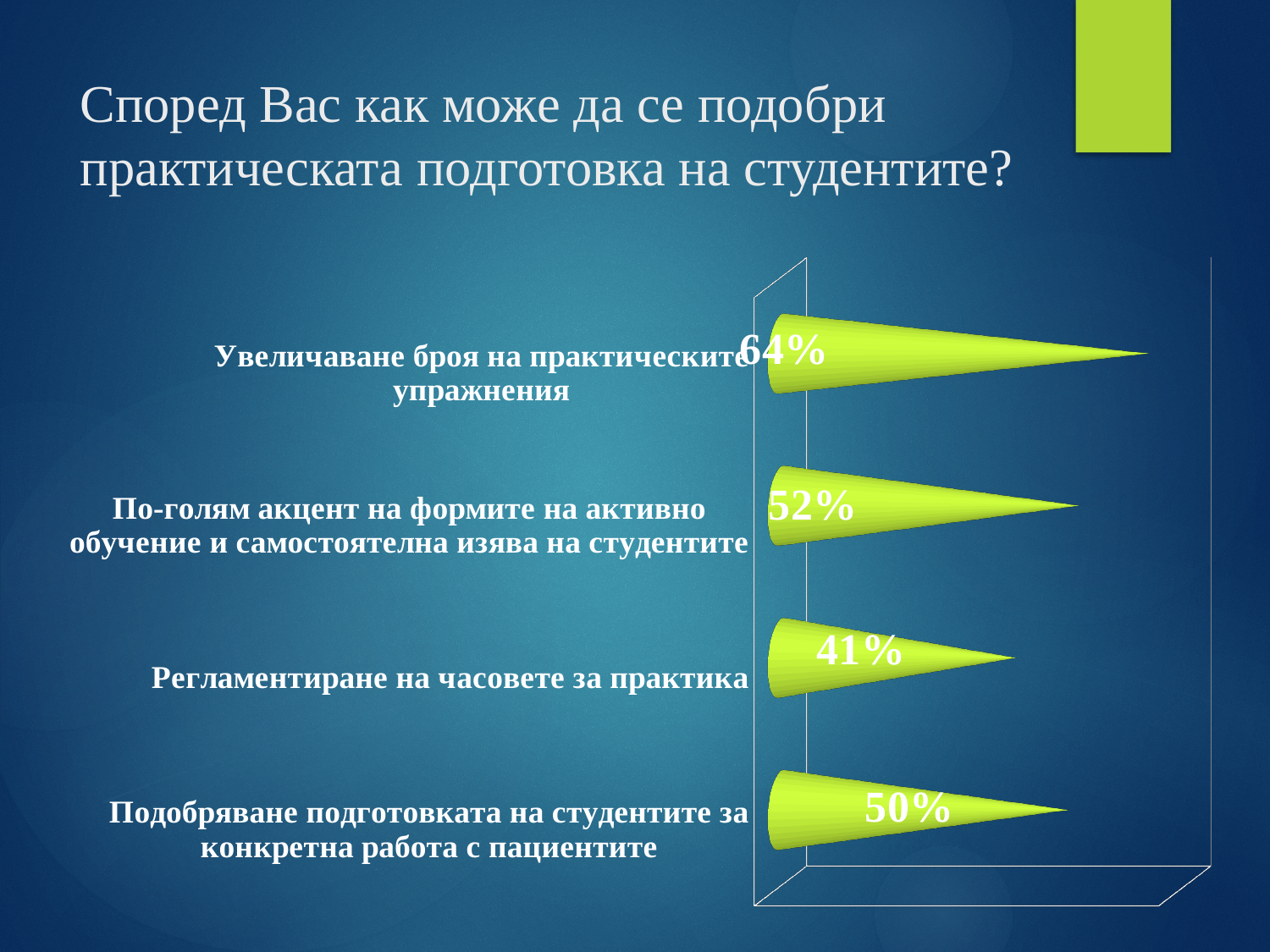
What question is the chart on the slide answering, according to the slide title? Според Вас как може да се подобри практическата подготовка на студентите? Which category has the lowest value? Регламентиране на часовете за практика Which is larger: the value for "Подобряване подготовката на студентите за конкретна работа с пациентите" or the value for "Регламентиране на часовете за практика"? Подобряване подготовката на студентите за конкретна работа с пациентите What value is shown for "Увеличаване броя на практическите упражнения"? 64% What value is shown for "Подобряване подготовката на студентите за конкретна работа с пациентите"? 50% How many categories are shown in the chart? 4 What kind of chart is shown on the slide? Bar chart What is the difference between the values for "По-голям акцент на формите на активно обучение и самостоятелна изява на студентите" and "Подобряване подготовката на студентите за конкретна работа с пациентите"? 2% What value is shown for "По-голям акцент на формите на активно обучение и самостоятелна изява на студентите"? 52% What is the difference between the values for "Увеличаване броя на практическите упражнения" and "Регламентиране на часовете за практика"? 23% What value is shown for "Регламентиране на часовете за практика"? 41% Which category has the highest value? Увеличаване броя на практическите упражнения